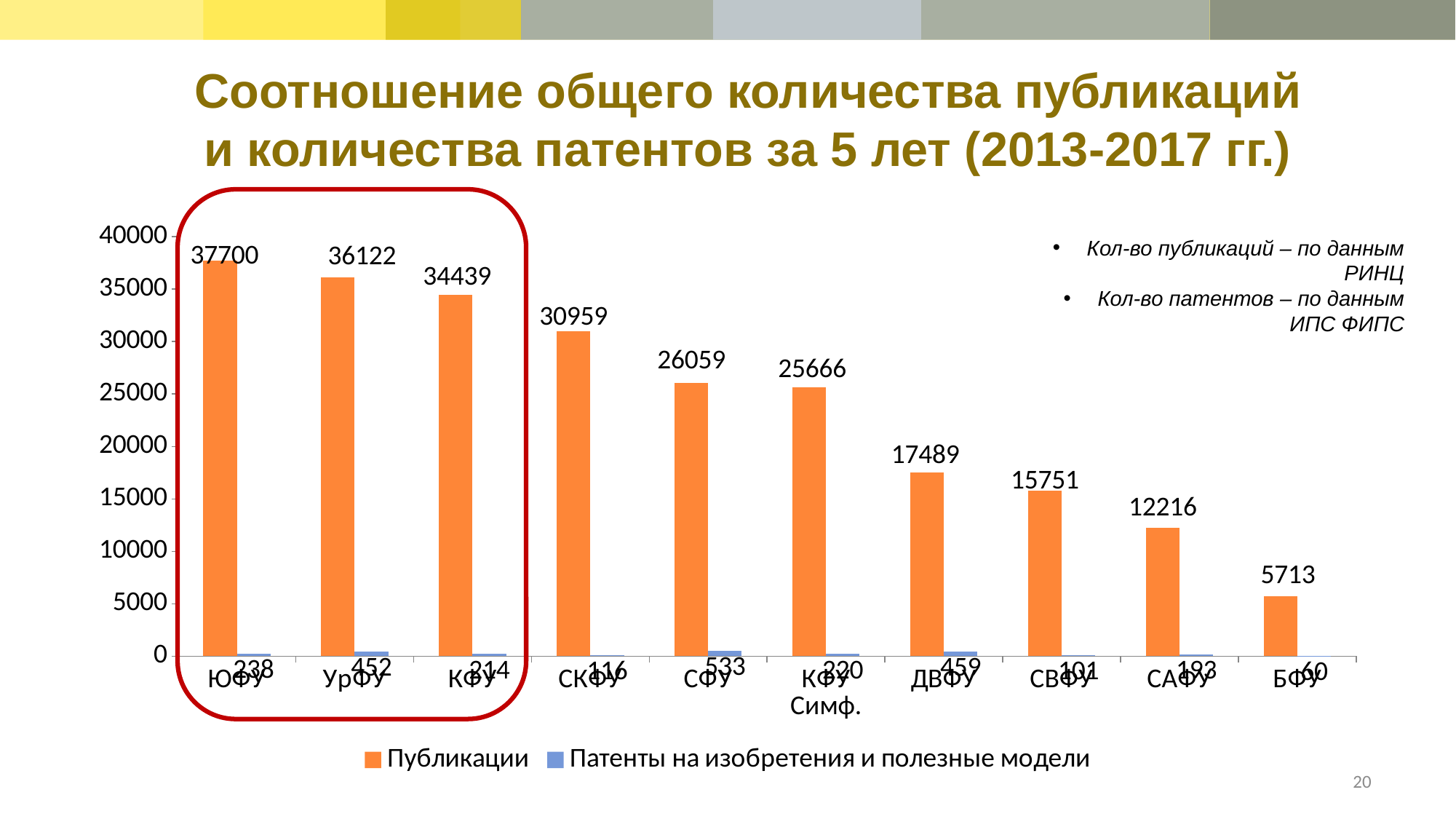
Which university has the highest number of publications? ЮФУ Which has more publications, ДВФУ or СВФУ? ДВФУ Do the publication values rise or fall from left to right along the x axis? fall What colour are the bars for the Публикации series? orange What is the number of publications (Публикации) for БФУ? 5713 What is the number of publications (Публикации) for ЮФУ? 37700 How many series does the legend list? 2 Which university has the lowest number of publications? БФУ How many universities (categories) are shown on the x axis? 10 What is the number of publications (Публикации) for СКФУ? 30959 What type of chart is shown on the slide? bar chart What is the difference in publications between ЮФУ and УрФУ? 1578